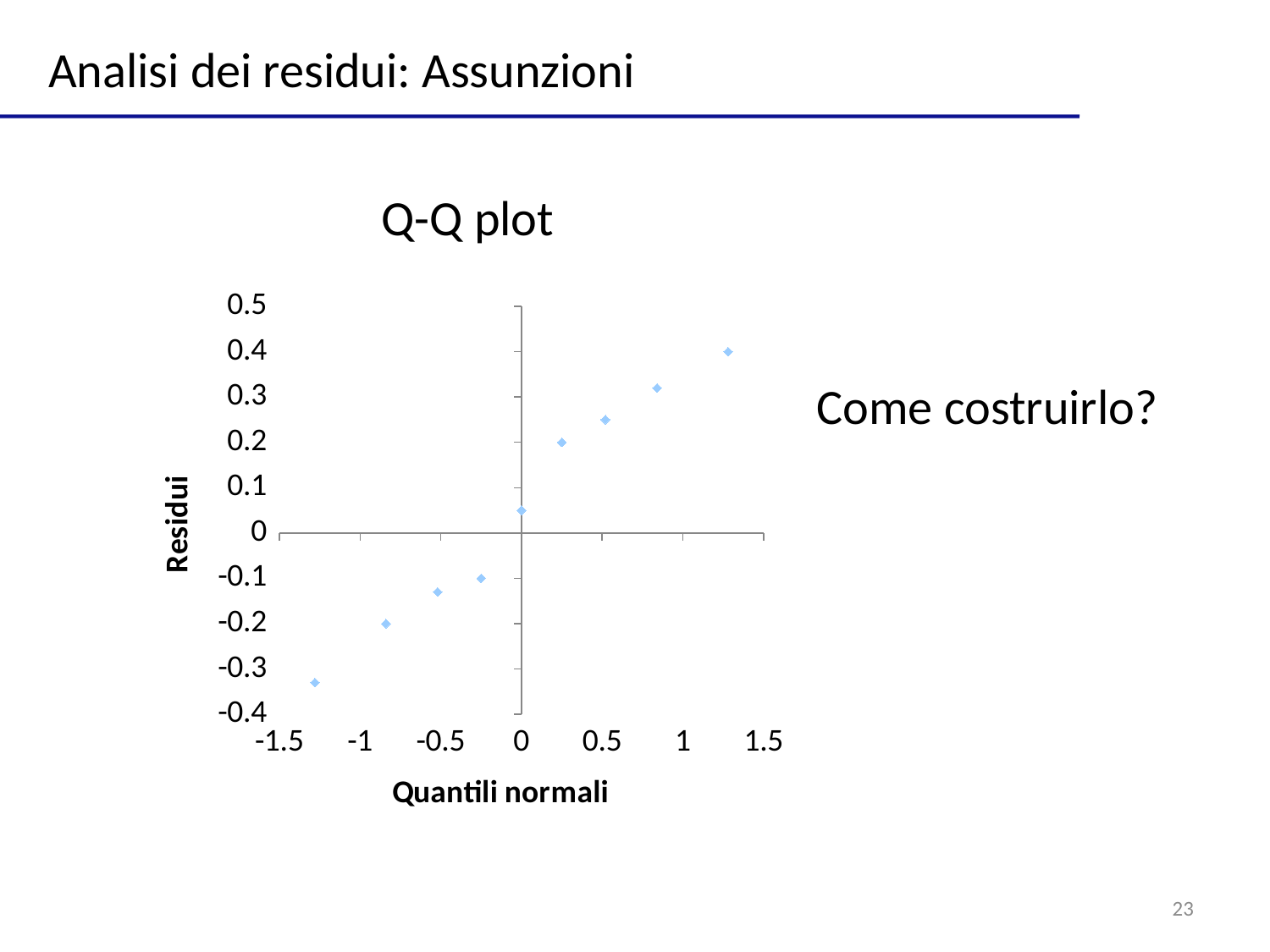
Is the residual of the point at normal quantile 0 greater or less than 0.1? less Do the residuals rise or fall as the normal quantiles increase along the x axis? rise What is the title of the chart? Q-Q plot What kind of chart is shown on the slide? scatter plot How many points in the chart have a negative residual? 4 What is the label of the x axis of the chart? Quantili normali Is the residual of the leftmost point (at the smallest normal quantile) greater or less than -0.3? less Which point has the highest residual: the one at the largest normal quantile or the one at the smallest normal quantile? the one at the largest normal quantile Is the residual of the rightmost point (at the largest normal quantile) greater or less than 0.3? greater What is the highest value shown on the y axis of the chart? 0.5 How many data points are plotted in the chart? 9